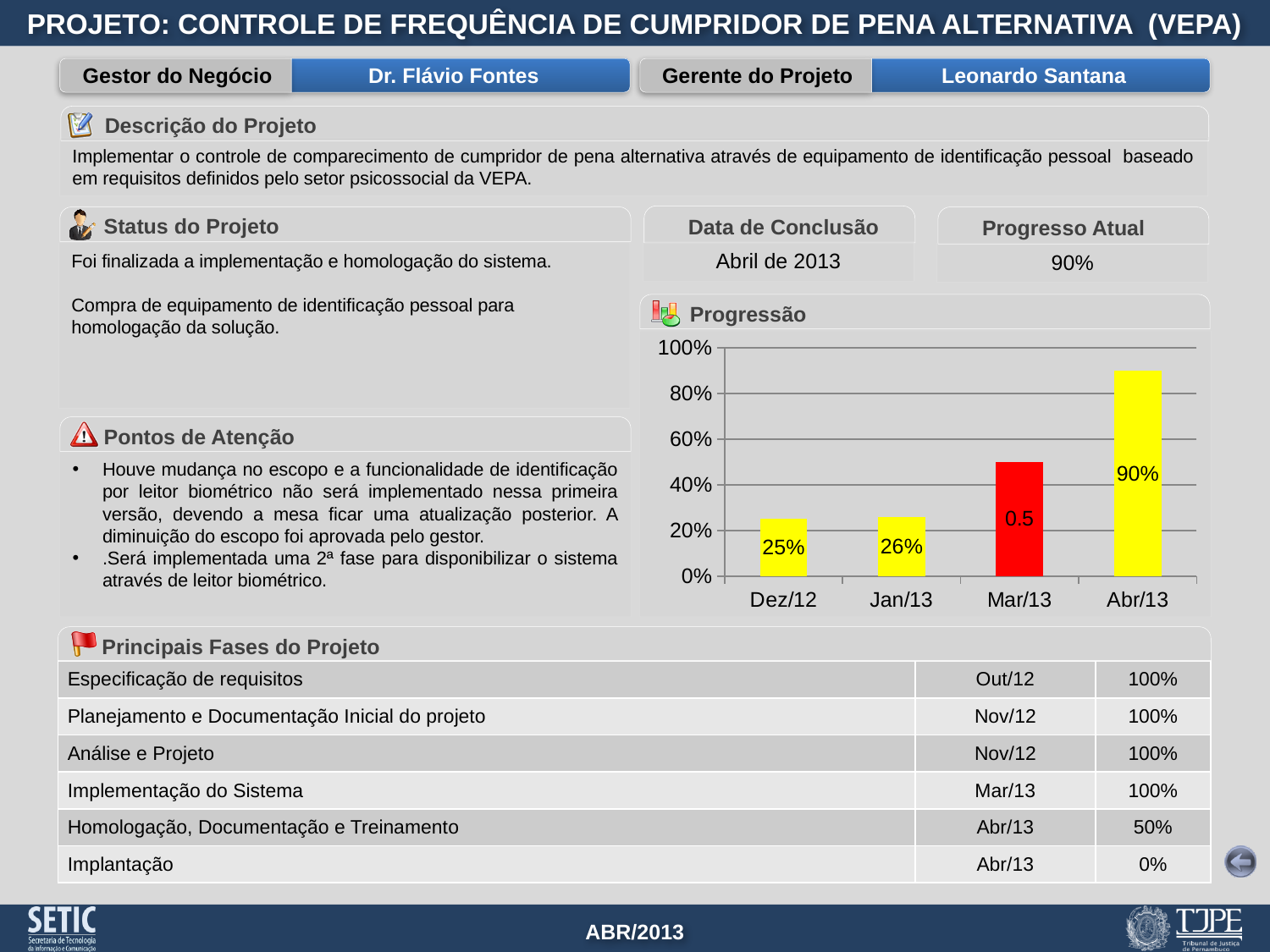
What is the value for Abr/13 in the Progressão chart? 90% In the Progressão chart, is the value for Mar/13 greater or less than 40%? greater How many months are shown on the x axis of the Progressão chart? 4 What is the difference between the Abr/13 and Dez/12 values in the Progressão chart? 65% In the Progressão chart, which is larger: the value for Mar/13 or the value for Abr/13? Abr/13 What colour is the Mar/13 bar in the Progressão chart? red Which month has the lowest value in the Progressão chart? Dez/12 What is the value for Jan/13 in the Progressão chart? 26% What data label is shown on the Mar/13 bar in the Progressão chart? 0.5 What is the value for Dez/12 in the Progressão chart? 25% Which month has the highest bar in the Progressão chart? Abr/13 What kind of chart is the Progressão chart? bar chart